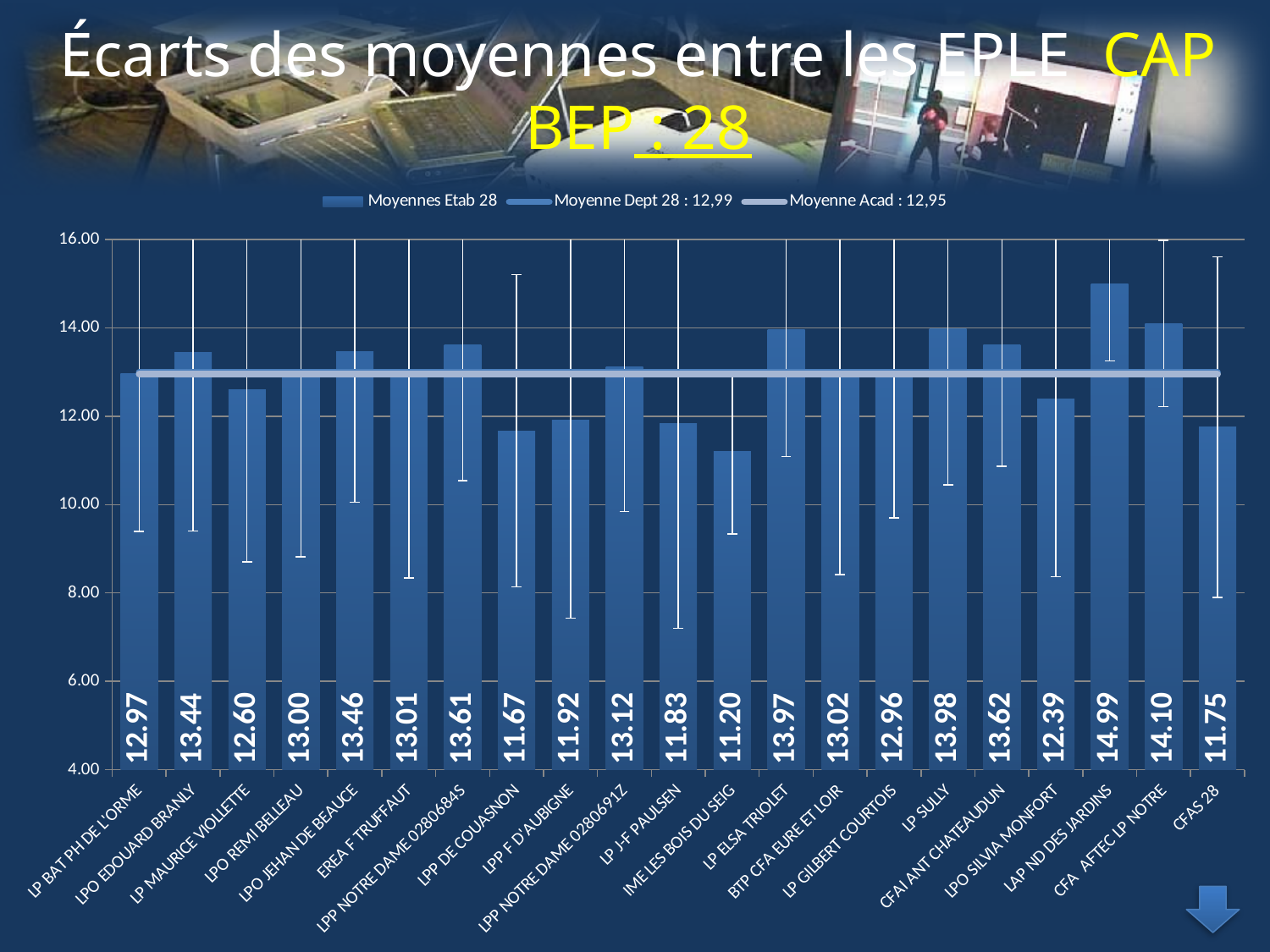
What is the difference between the values for CFA AFTEC LP NOTRE and CFAS 28? 2.35 What is the value for IME LES BOIS DU SEIG? 11.20 How many establishments are shown on the x axis? 21 What kind of chart is this? bar chart What is the value for LP SULLY? 13.98 What is the value for LPP NOTRE DAME 0280684S? 13.61 Which is larger, the value for LPO EDOUARD BRANLY or the value for LP MAURICE VIOLLETTE? LPO EDOUARD BRANLY Is the value for LP ELSA TRIOLET greater or less than 12.00? greater What value does the legend give for Moyenne Dept 28? 12,99 Which establishment has the highest value? LAP ND DES JARDINS Which establishment has the lowest value? IME LES BOIS DU SEIG How many series does the legend list? 3